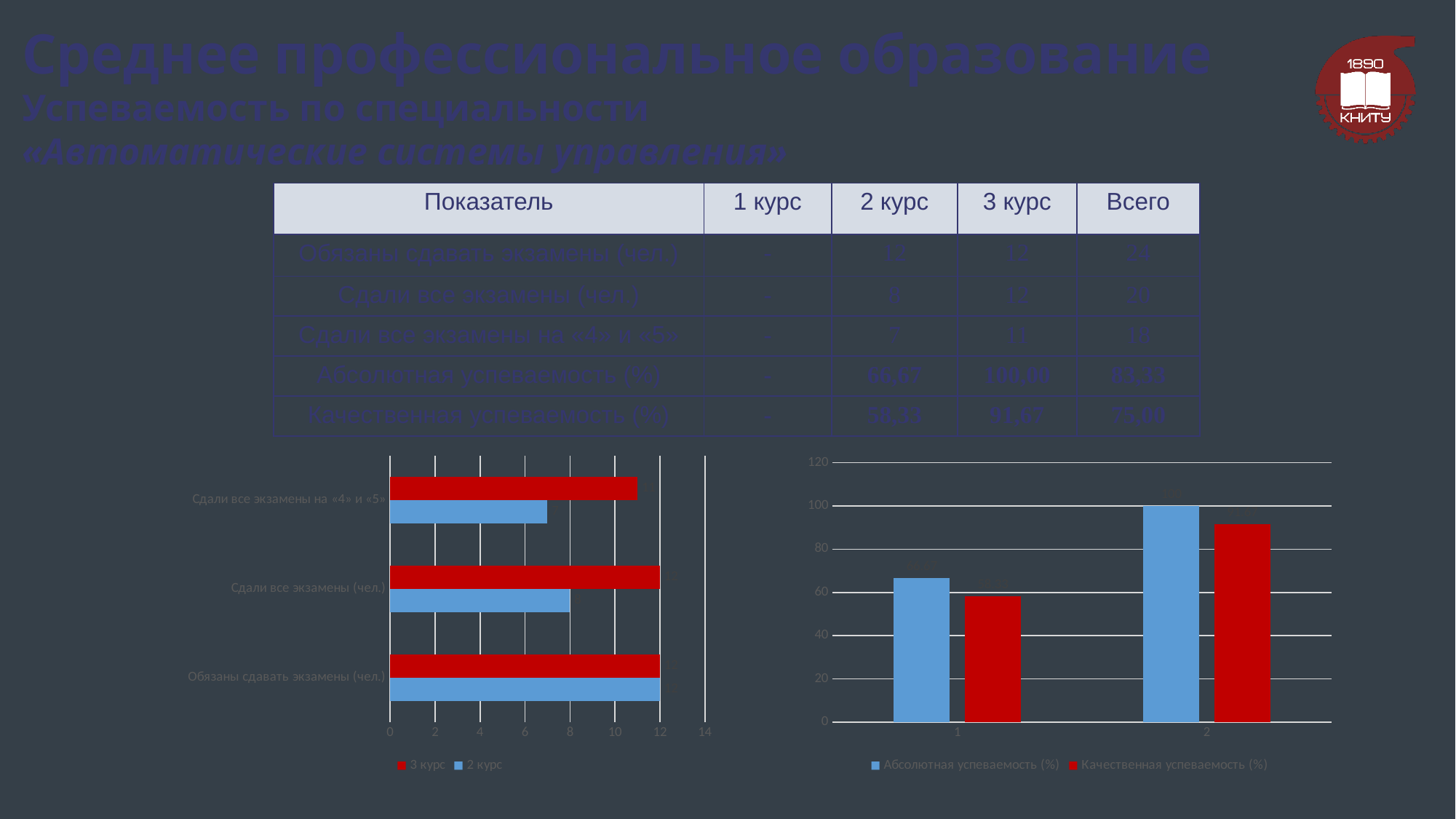
In the left chart, which colour represents the 3 курс series? red In the right chart, how many series does the legend list? 2 In the right chart, is the value of Качественная успеваемость (%) for category 1 greater or less than 60? less In the right chart, what is the value of Абсолютная успеваемость (%) for category 2? 100 In the left chart, what is the value of the 2 курс series for «Обязаны сдавать экзамены (чел.)»? 12 What kind of chart is the chart on the right of the slide? bar chart In the left chart, which series has the larger value for «Сдали все экзамены (чел.)», 2 курс or 3 курс? 3 курс In the left chart, is the value of the 3 курс series for «Сдали все экзамены на «4» и «5»» greater or less than 10? greater In the left chart, how many series does the legend list? 2 In the left chart, what is the value of the 2 курс series for «Сдали все экзамены (чел.)»? 8 In the left chart, how many categories are shown on the vertical axis? 3 What kind of chart is the chart on the left of the slide? bar chart